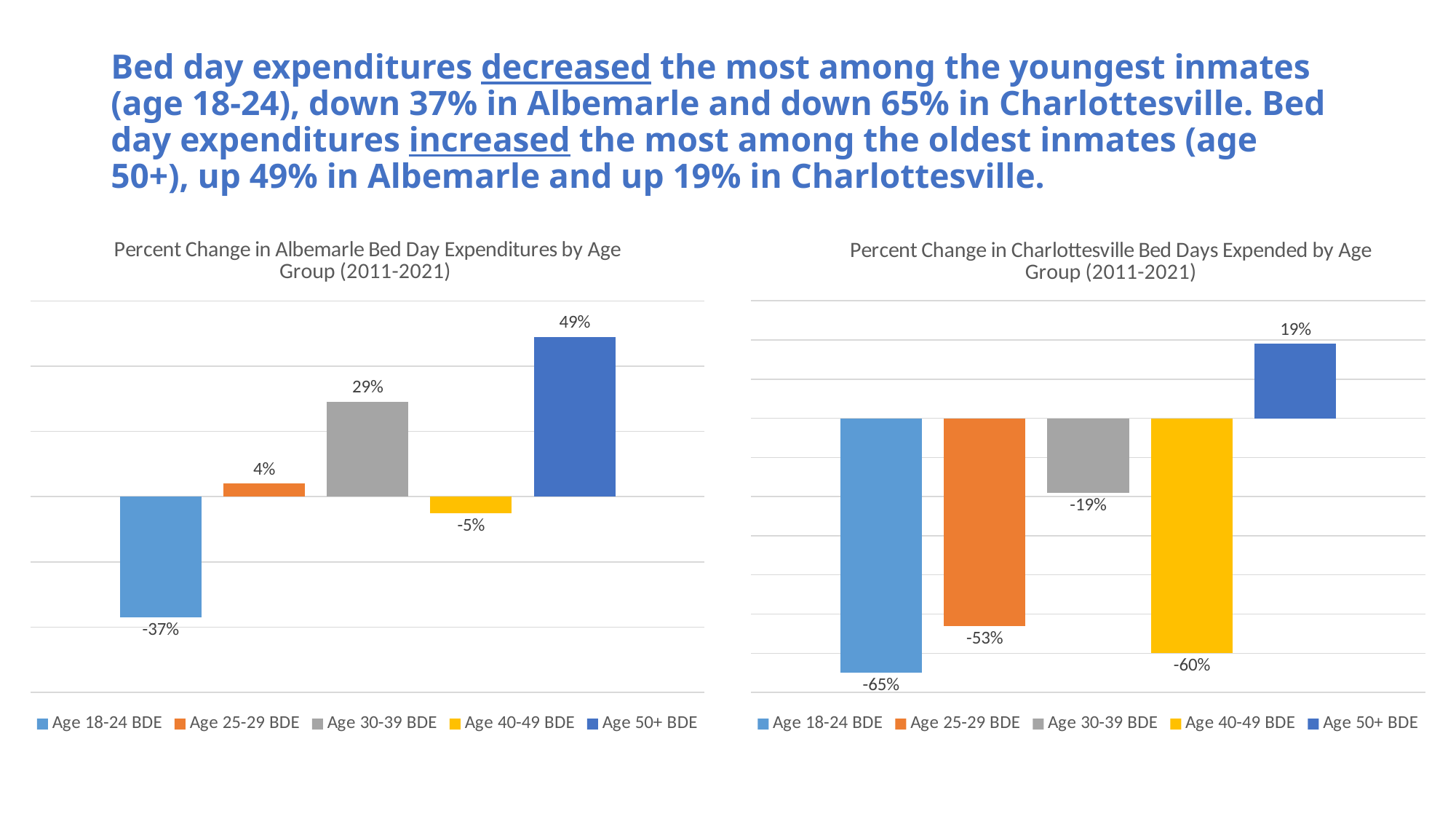
In the Charlottesville chart, which is larger: the percent change for Age 25-29 BDE or Age 30-39 BDE? Age 30-39 BDE What type of chart is the Albemarle chart? Bar chart How many series does the legend of the Charlottesville chart list? 5 In the Albemarle chart, what is the percent change for Age 18-24 BDE? -37% In the Albemarle chart, what is the percent change for Age 30-39 BDE? 29% In the Albemarle chart, which colour represents Age 40-49 BDE? Yellow In the Albemarle chart, what is the difference between the percent change for Age 50+ BDE and Age 30-39 BDE? 20 percentage points In the Charlottesville chart, which age group has the lowest percent change? Age 18-24 BDE In the Charlottesville chart, which age group has the highest percent change? Age 50+ BDE In the Charlottesville chart, what is the percent change for Age 40-49 BDE? -60% How many age groups are shown in the Albemarle chart? 5 In the Albemarle chart, which age group has the lowest percent change? Age 18-24 BDE